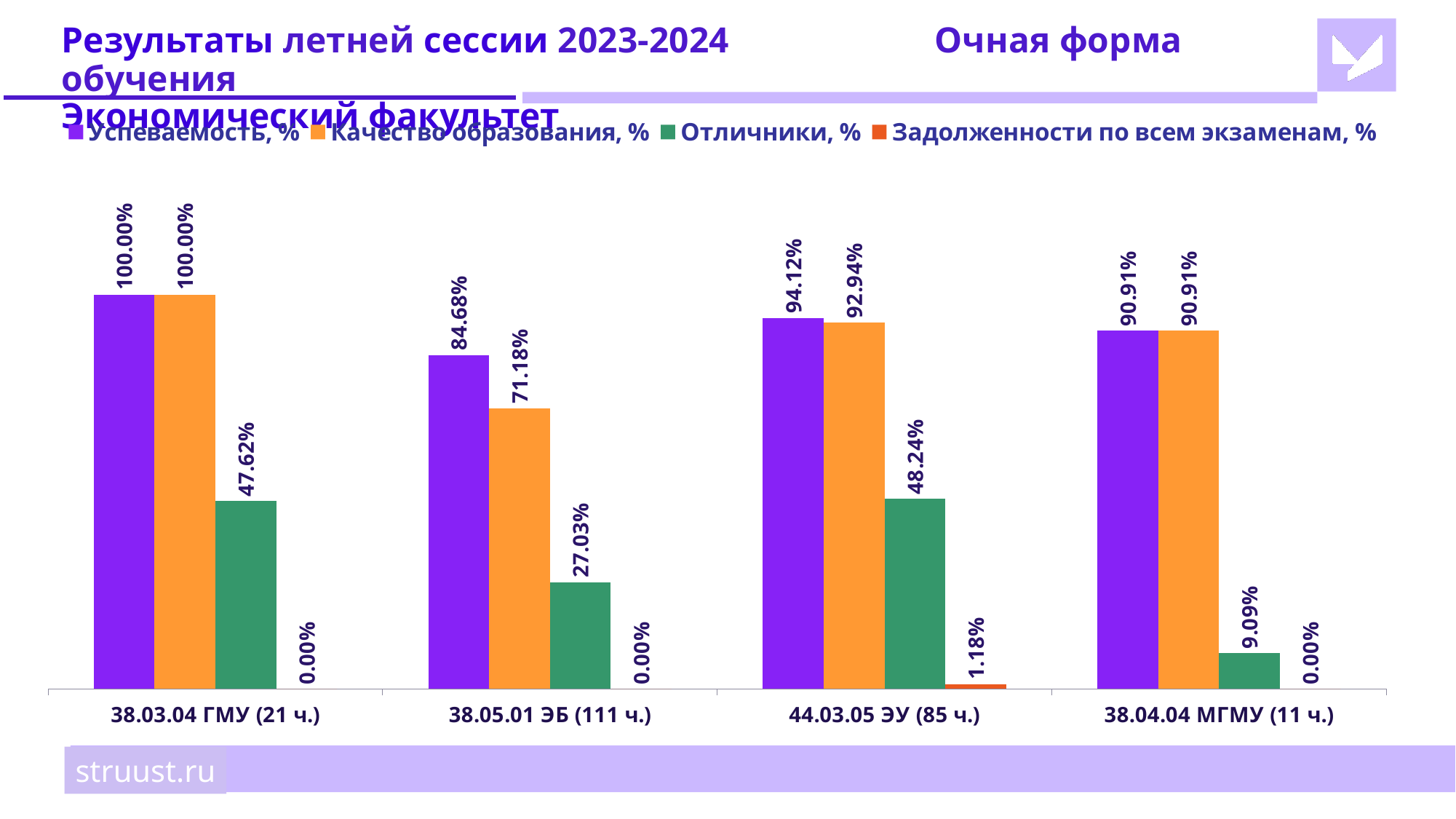
Which is larger for 38.03.04 ГМУ (21 ч.): Отличники, % or Отличники, % for 38.05.01 ЭБ (111 ч.)? 38.03.04 ГМУ (21 ч.) What is the value of Успеваемость, % for 38.05.01 ЭБ (111 ч.)? 84.68% How many series does the legend list? 4 Which category has the lowest value of Успеваемость, %? 38.05.01 ЭБ (111 ч.) How many categories are shown on the x axis? 4 What is the value of Отличники, % for 38.04.04 МГМУ (11 ч.)? 9.09% Which colour represents Задолженности по всем экзаменам, % in the legend? Red-orange What is the value of Задолженности по всем экзаменам, % for 44.03.05 ЭУ (85 ч.)? 1.18% Which category has the highest value of Отличники, %? 44.03.05 ЭУ (85 ч.) What kind of chart is shown on the slide? Bar chart What is the difference between Успеваемость, % and Качество образования, % for 38.05.01 ЭБ (111 ч.)? 13.50% What is the value of Качество образования, % for 44.03.05 ЭУ (85 ч.)? 92.94%